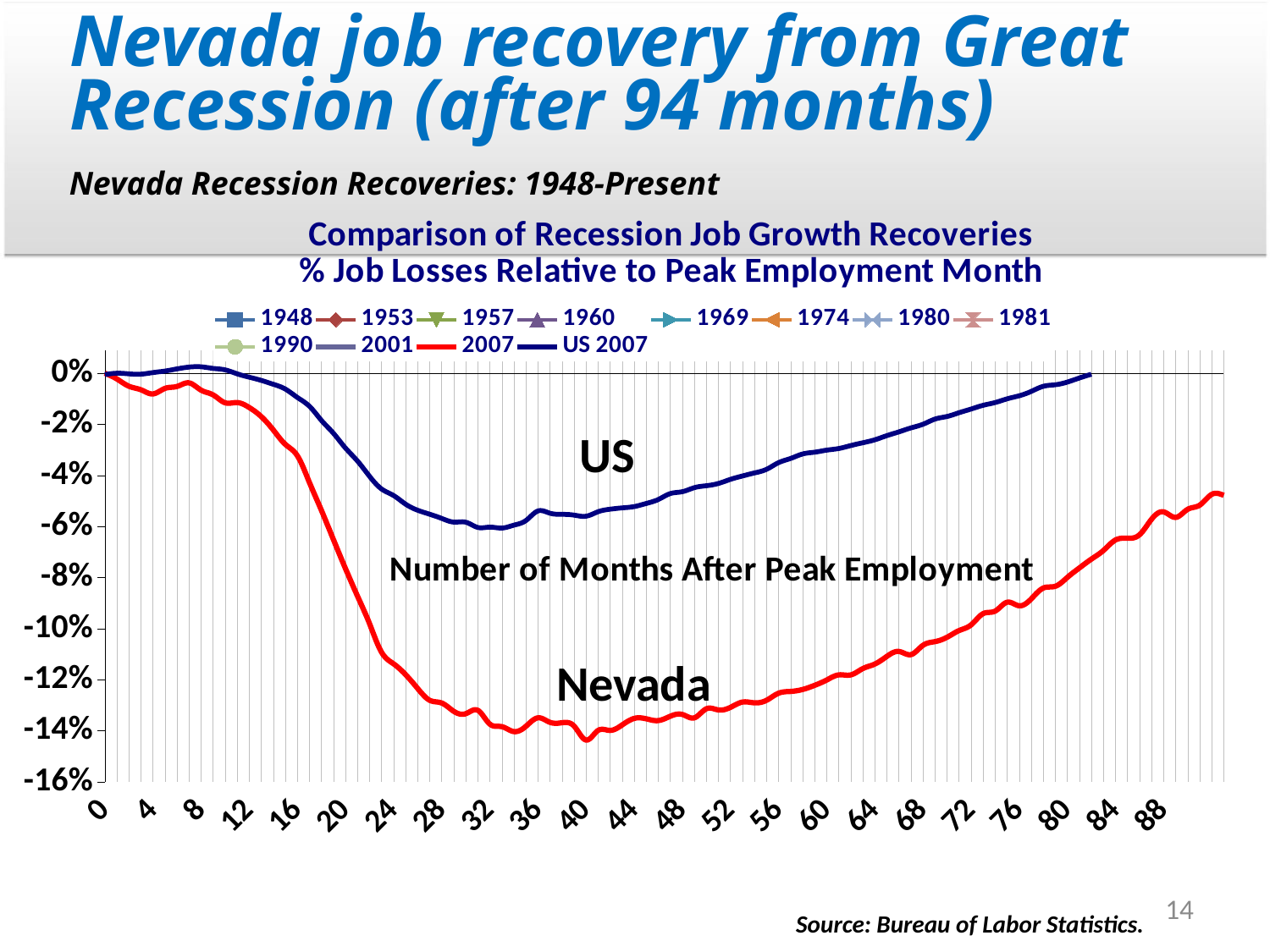
Which of the two plotted lines reaches the lowest value? Nevada What is the title of the chart? Comparison of Recession Job Growth Recoveries % Job Losses Relative to Peak Employment Month Does the Nevada line rise or fall between month 48 and month 88? rise Is the US value at month 72 greater or less than -2%? greater Is the US value at month 48 greater or less than -6%? greater What kind of chart is shown on the slide? line chart What is the x-axis label of the chart? Number of Months After Peak Employment At month 40, which line is higher, US or Nevada? US How many series does the chart legend list? 12 Is the Nevada value at month 48 greater or less than -12%? less Does the US line rise or fall between month 8 and month 32? fall